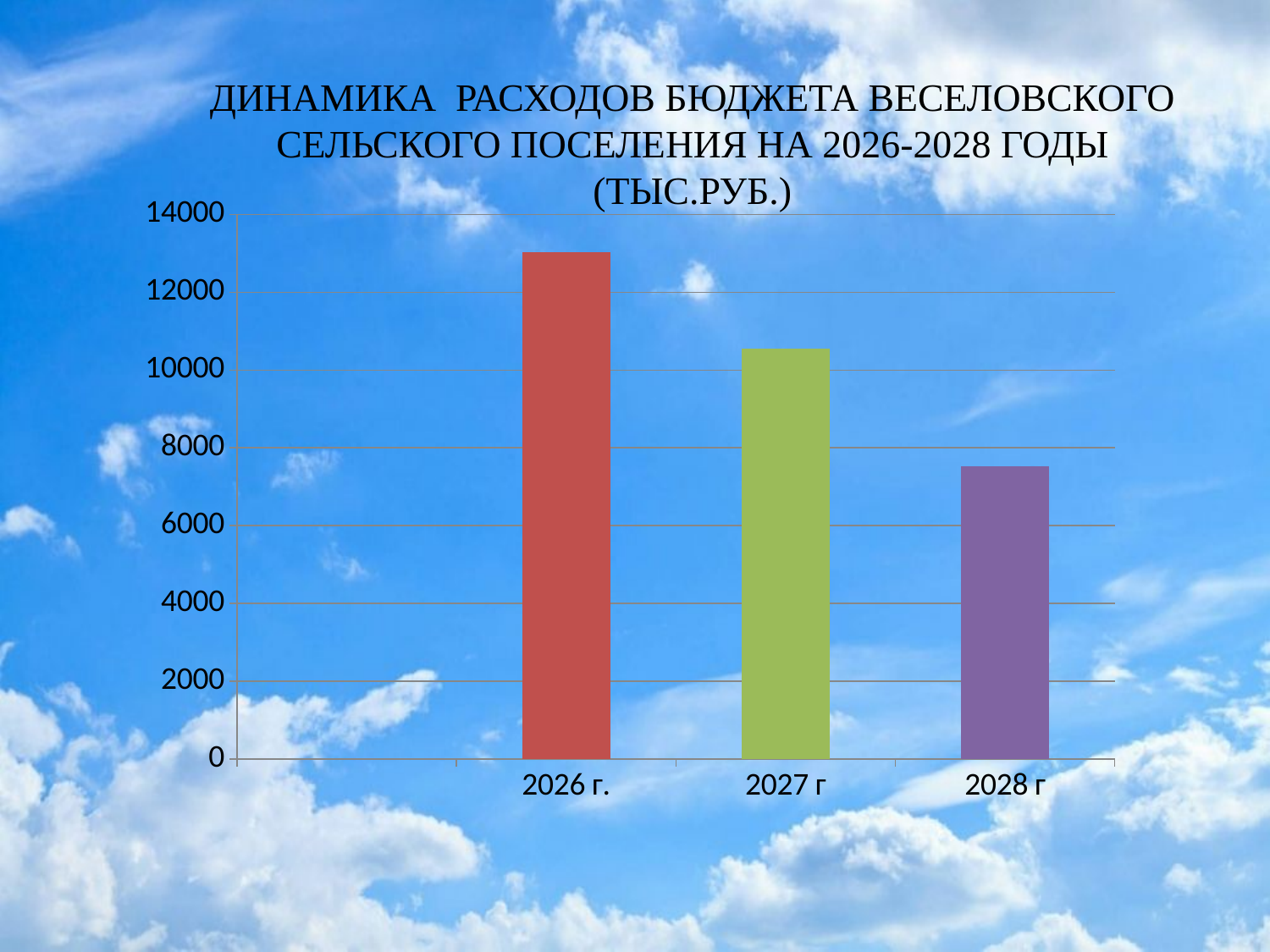
Is the value for 2028 г greater or less than 8000? less Is the value for 2028 г greater or less than 6000? greater How many years (categories) are plotted on the chart? 3 What is the title of the chart? ДИНАМИКА РАСХОДОВ БЮДЖЕТА ВЕСЕЛОВСКОГО СЕЛЬСКОГО ПОСЕЛЕНИЯ НА 2026-2028 ГОДЫ (ТЫС.РУБ.) Which is larger, the value for 2026 г. or the value for 2027 г? 2026 г. Which year has the lowest budget expenditure on the chart? 2028 г Is the value for 2027 г greater or less than 10000? greater Which year has the highest budget expenditure on the chart? 2026 г. Do the values rise or fall from 2026 to 2028 along the x axis? fall What kind of chart is shown on the slide? bar chart What colour is the bar for 2027 г? green